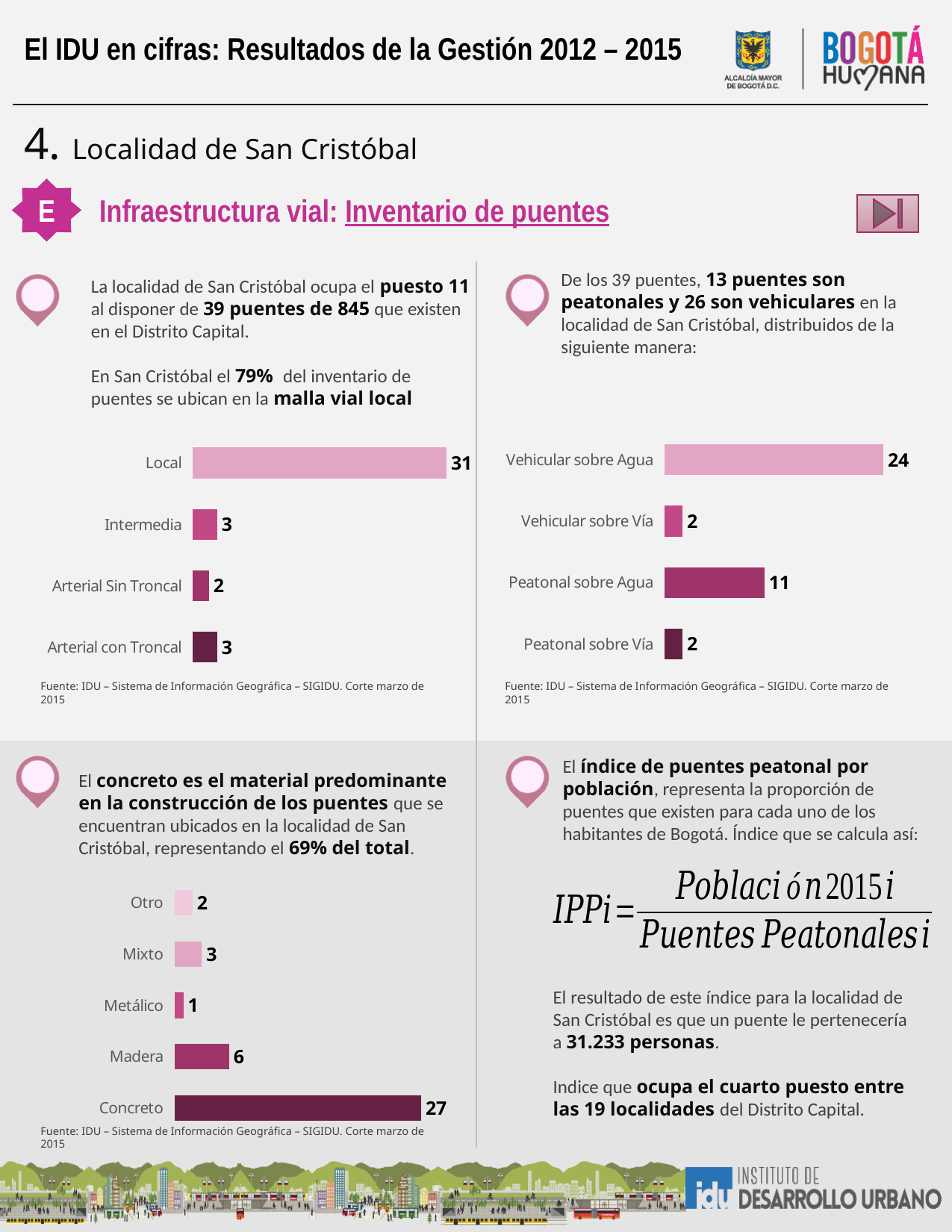
In the bottom-left bar chart, how many categories are shown? 5 In the top-left bar chart, what is the difference between Local and Intermedia? 28 In the bottom-left bar chart, what is the value for Madera? 6 What type of chart is the bottom-left chart? Bar chart In the top-left bar chart, how many categories are shown? 4 In the top-right bar chart, which is larger, Vehicular sobre Agua or Peatonal sobre Agua? Vehicular sobre Agua In the top-right bar chart, which category has the highest value? Vehicular sobre Agua In the bottom-left bar chart, which category has the lowest value? Metálico In the top-left bar chart, what is the value for Local? 31 In the top-left bar chart, which category has the lowest value? Arterial Sin Troncal In the top-right bar chart, what is the value for Peatonal sobre Agua? 11 In the top-right bar chart, what is the difference between Vehicular sobre Agua and Peatonal sobre Agua? 13